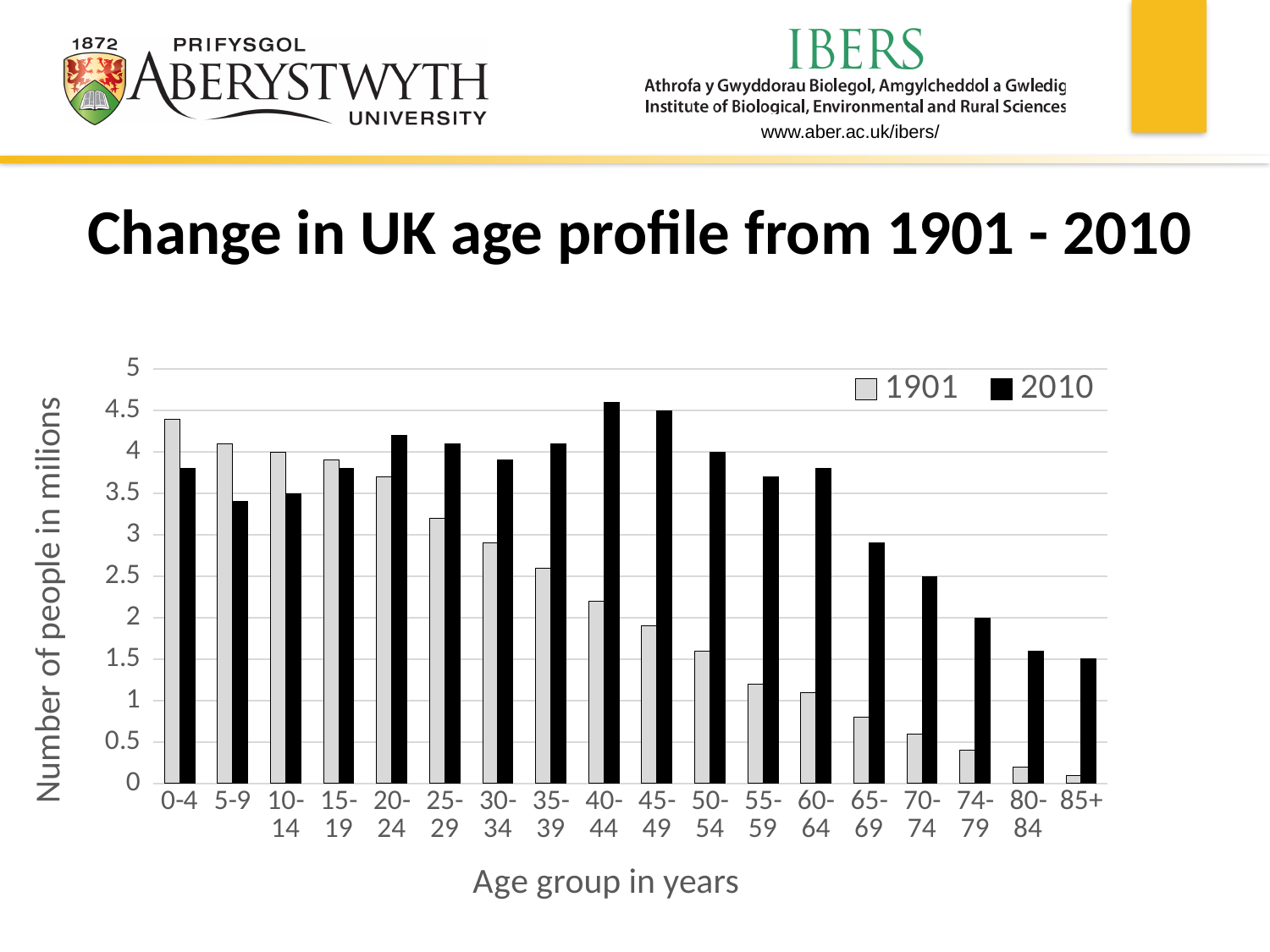
Which age group has the highest value for the 1901 series? 0-4 Is the 2010 value for the 85+ age group greater or less than 1? greater What kind of chart is shown on the slide? bar chart For the 40-44 age group, which series has the larger value, 1901 or 2010? 2010 Do the 1901 values rise or fall as age group increases along the x axis? fall Which age group has the lowest value for the 1901 series? 85+ What is the title of the chart? Change in UK age profile from 1901 - 2010 How many series does the legend list? 2 How many age groups are shown on the x axis? 18 For the 0-4 age group, which series has the larger value, 1901 or 2010? 1901 Is the 1901 value for the 0-4 age group greater or less than 4? greater Is the 1901 value for the 85+ age group greater or less than 0.5? less